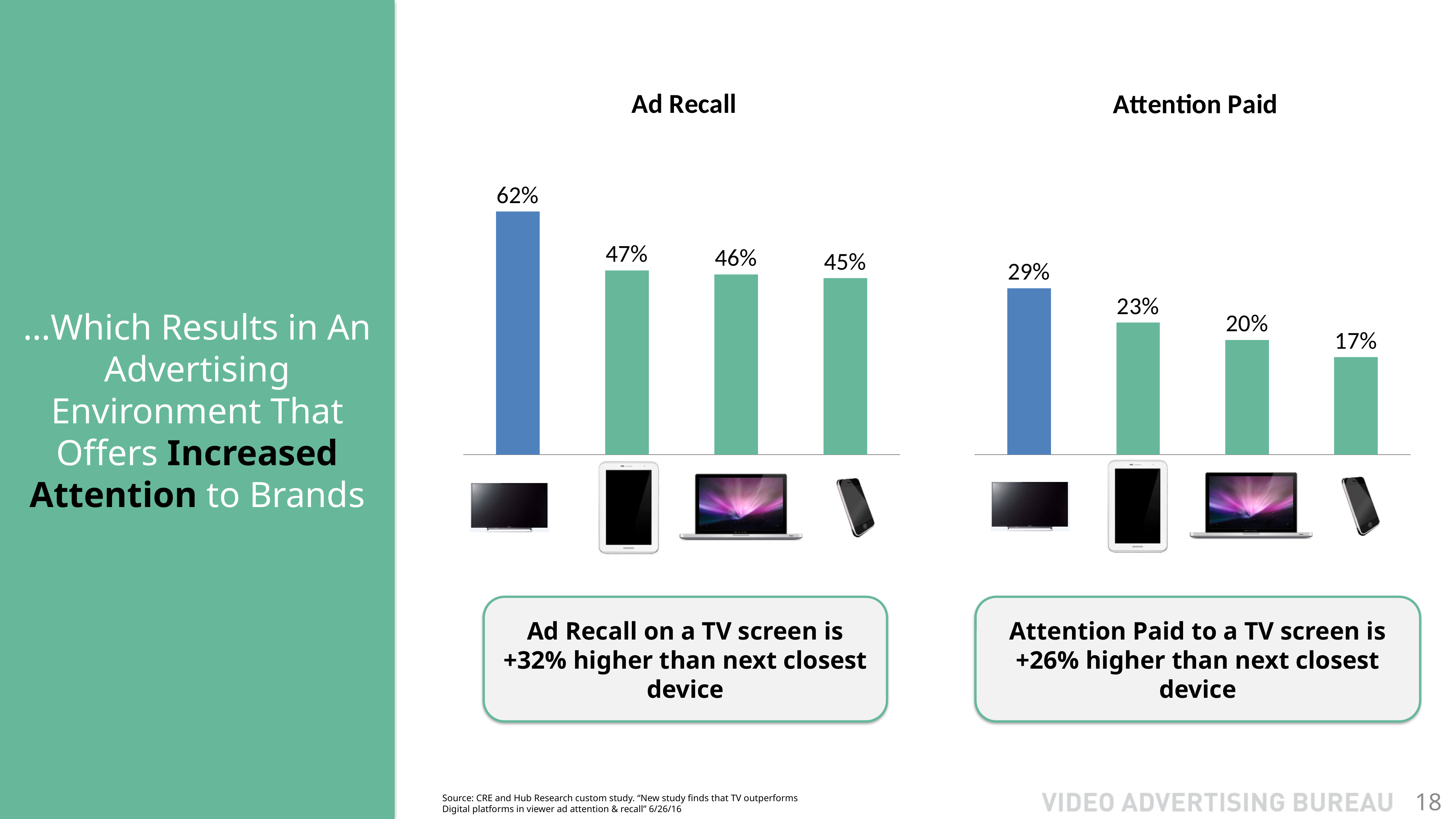
In the Ad Recall chart, what colour is the first (TV) bar? Blue What kind of chart is the Attention Paid chart? Bar chart In the Attention Paid chart, what is the value shown for the first bar (the TV)? 29% In the Ad Recall chart, what is the value shown for the first bar (the TV)? 62% In the Ad Recall chart, what is the difference between the first bar (62%) and the second bar (47%)? 15 percentage points In the Attention Paid chart, what is the difference between the first bar (29%) and the last bar (17%)? 12 percentage points In the Attention Paid chart, do the values rise or fall from left to right? Fall In the Ad Recall chart, what is the lowest value shown? 45% In the Attention Paid chart, what is the lowest value shown? 17% In the Ad Recall chart, which device has the highest value? TV (first bar) How many bars are plotted in the Ad Recall chart? 4 Which is larger: the second bar in the Ad Recall chart or the second bar in the Attention Paid chart? The second bar in the Ad Recall chart (47%)